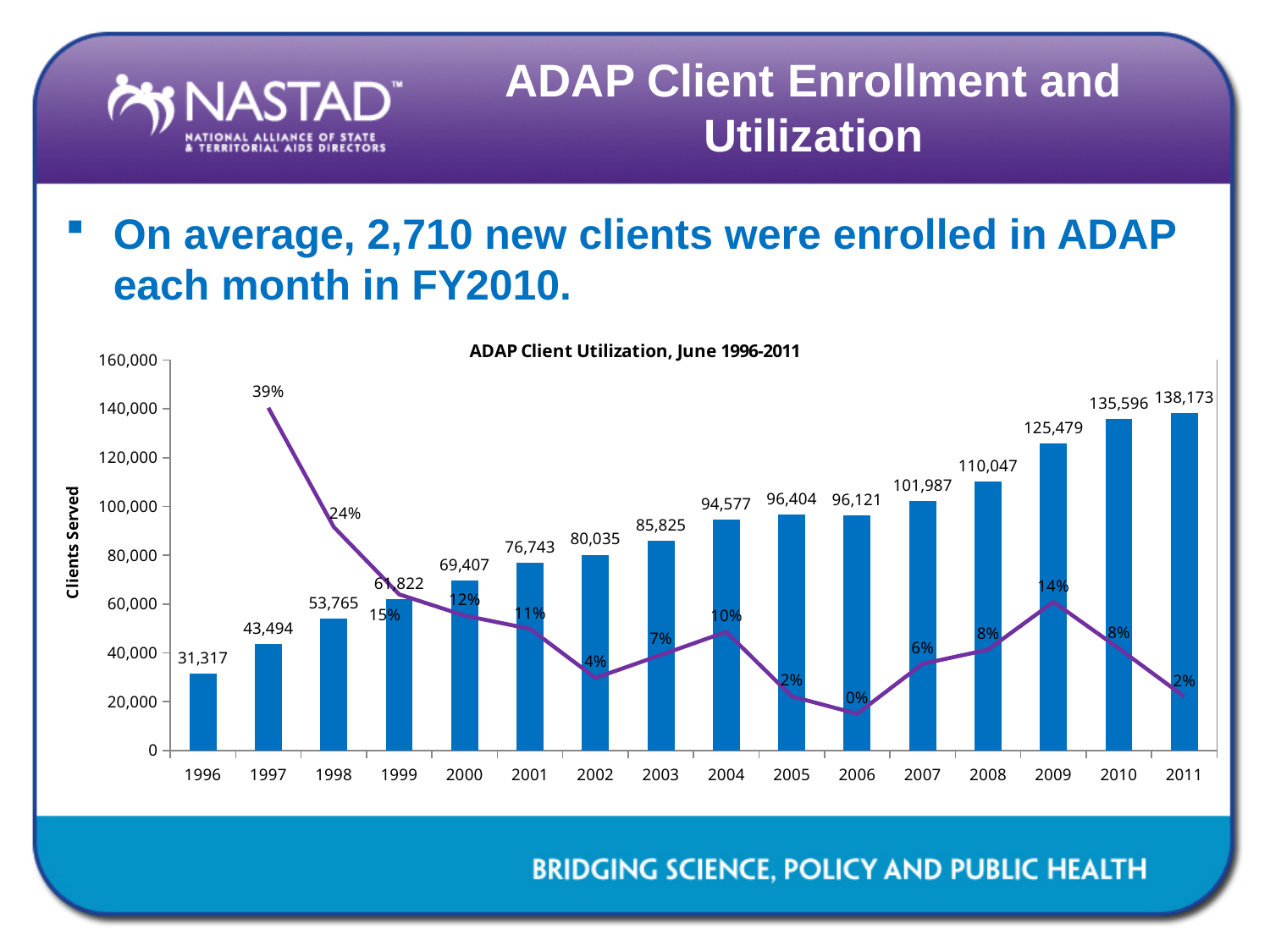
How many clients were served in 2011 according to the ADAP Client Utilization chart? 138,173 Which year has the highest number of clients served? 2011 What kind of chart is shown on the slide? bar chart with a line What is the difference in clients served between 2011 and 2010? 2,577 Which year has the lowest number of clients served? 1996 Which year had more clients served, 2008 or 2009? 2009 Do the bars for clients served generally rise or fall from 1996 to 2011? rise What percentage growth is shown on the line for 1997? 39% How many years are shown on the x axis of the chart? 16 What is the title of the chart? ADAP Client Utilization, June 1996-2011 What is the number of clients served in 1996? 31,317 What percentage is labeled on the line for 2006? 0%